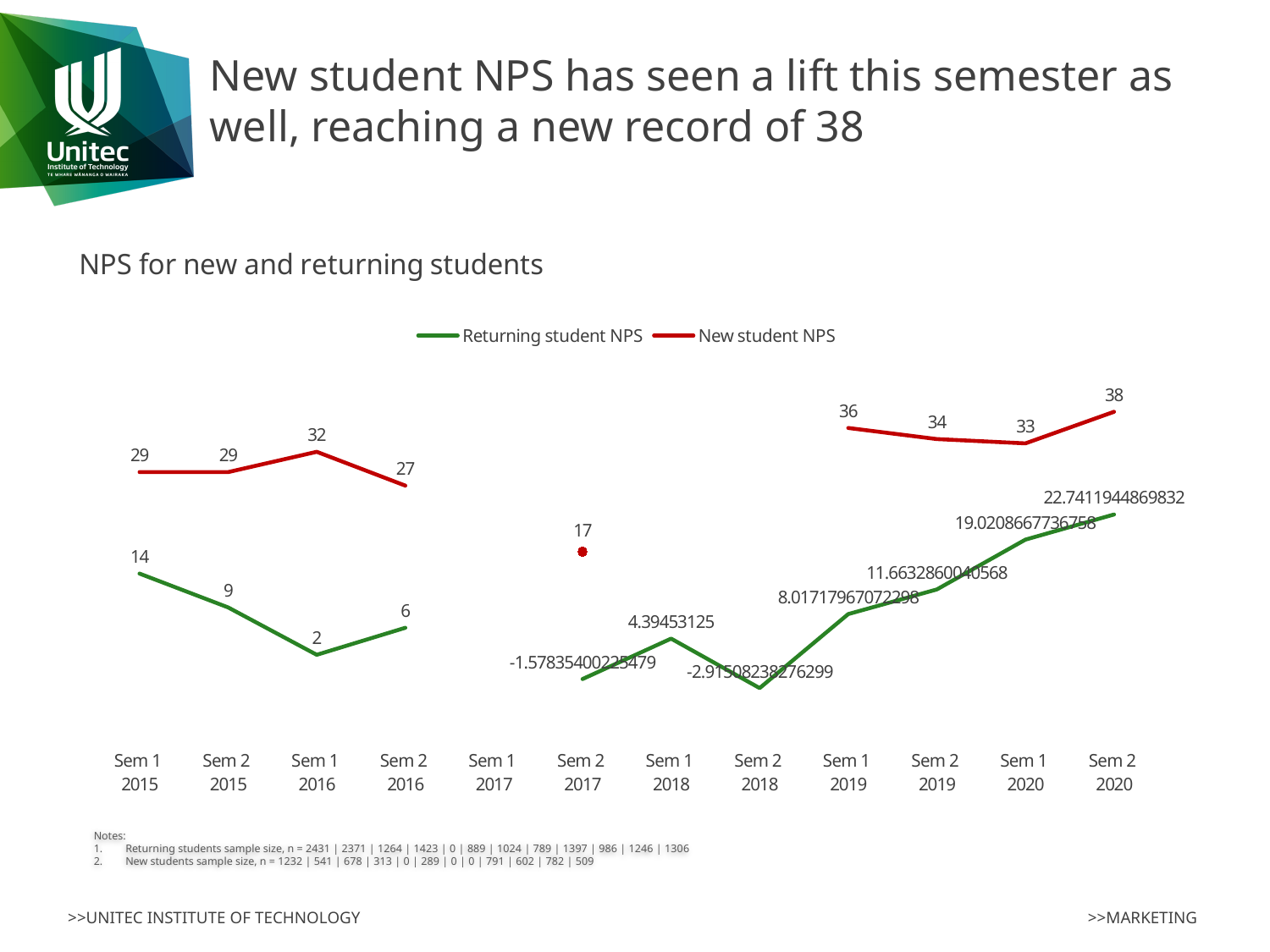
What is the New student NPS for Sem 2 2020? 38 What is the Returning student NPS for Sem 1 2015? 14 In Sem 1 2016, which is larger: the New student NPS or the Returning student NPS? New student NPS How many series does the legend list? 2 What is the Returning student NPS for Sem 1 2018? 4.39453125 In which semester is the New student NPS highest? Sem 2 2020 How many semesters are shown on the x axis? 12 What kind of chart is shown on the slide? line chart What is the New student NPS for Sem 1 2019? 36 Does the Returning student NPS rise or fall from Sem 1 2019 to Sem 2 2020? rise What is the difference between the New student NPS in Sem 2 2020 and Sem 1 2020? 5 In which semester is the New student NPS lowest? Sem 2 2017